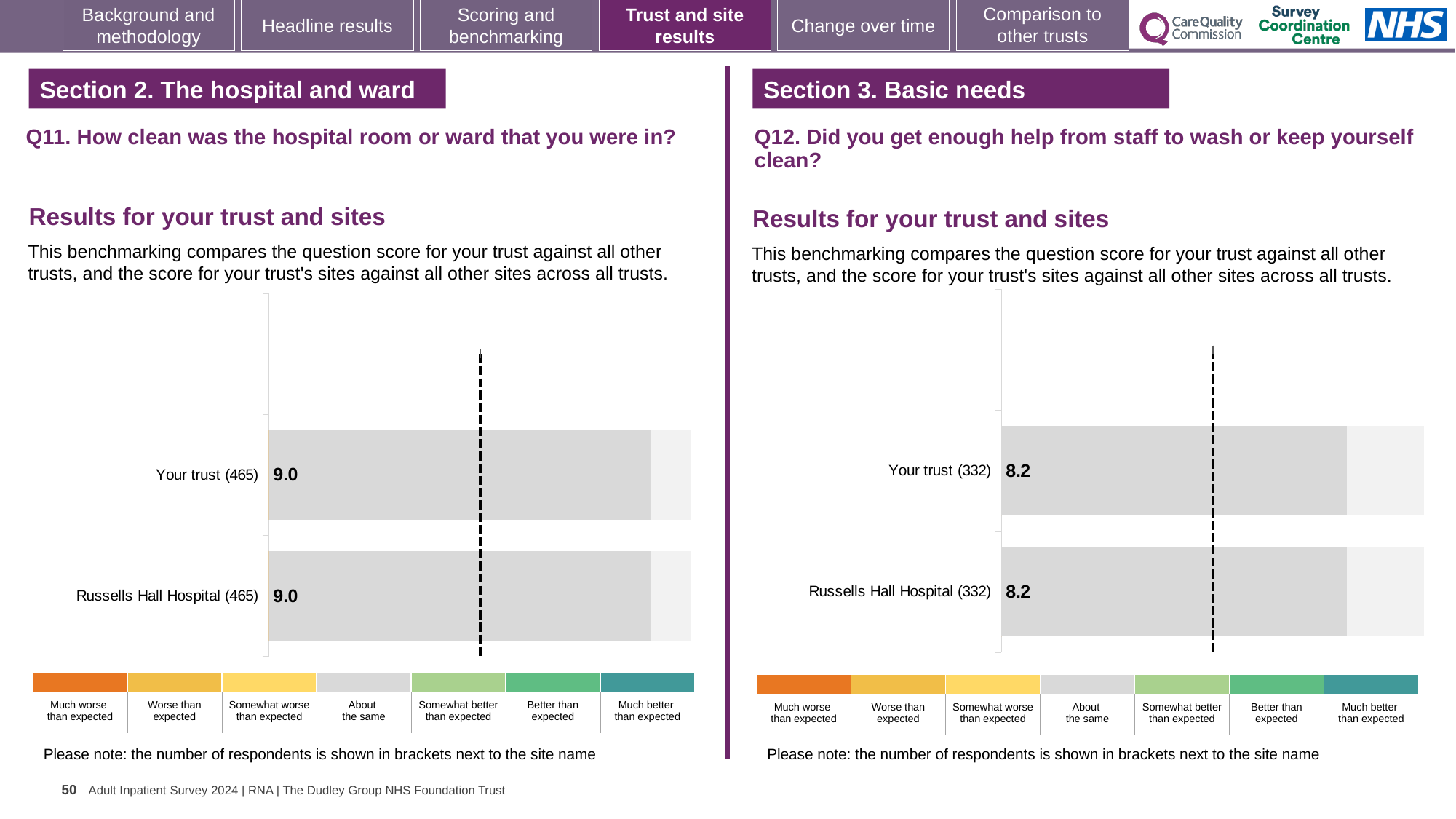
How many bars are plotted in the Q11 chart on the left? 2 In the Q11 chart on the left, what is the difference between the score for Your trust and the score for Russells Hall Hospital? 0.0 In the Q12 chart on the right, what is the score for Your trust? 8.2 Is the score for Your trust in the Q11 chart on the left larger or smaller than the score for Your trust in the Q12 chart on the right? Larger What kind of chart is used for the Q11 results on the left? Bar chart In the Q12 chart on the right, how many respondents are shown in brackets next to Russells Hall Hospital? 332 In the Q11 chart on the left, what is the score for Russells Hall Hospital? 9.0 In the Q12 chart on the right, what is the difference between the score for Your trust and the score for Russells Hall Hospital? 0.0 How many bars are plotted in the Q12 chart on the right? 2 In the Q11 chart on the left, how many respondents are shown in brackets next to Your trust? 465 In the Q12 chart on the right, what is the score for Russells Hall Hospital? 8.2 In the Q11 chart on the left, what is the score for Your trust? 9.0